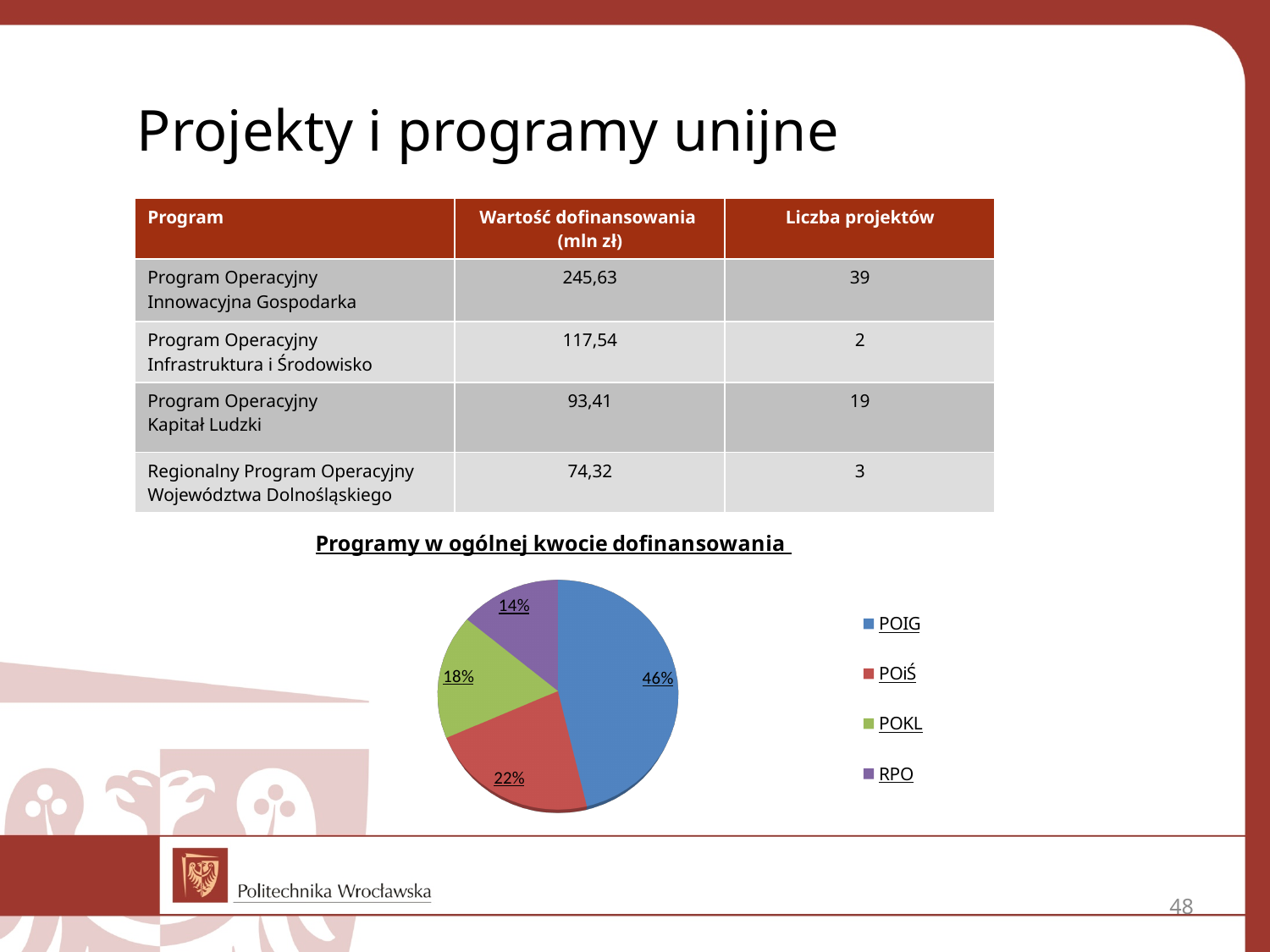
What share of the pie chart does POIG represent? 46% What share of the pie chart does POKL represent? 18% What type of chart is shown on the slide? Pie chart What is the difference in percentage points between the POIG slice and the POiŚ slice? 24 How many entries does the pie chart legend list? 4 Which program has the largest slice in the pie chart? POIG What share of the pie chart does POiŚ represent? 22% Which slice is larger in the pie chart, POKL or RPO? POKL What is the title of the pie chart? Programy w ogólnej kwocie dofinansowania How many slices does the pie chart have? 4 Which program has the smallest slice in the pie chart? RPO